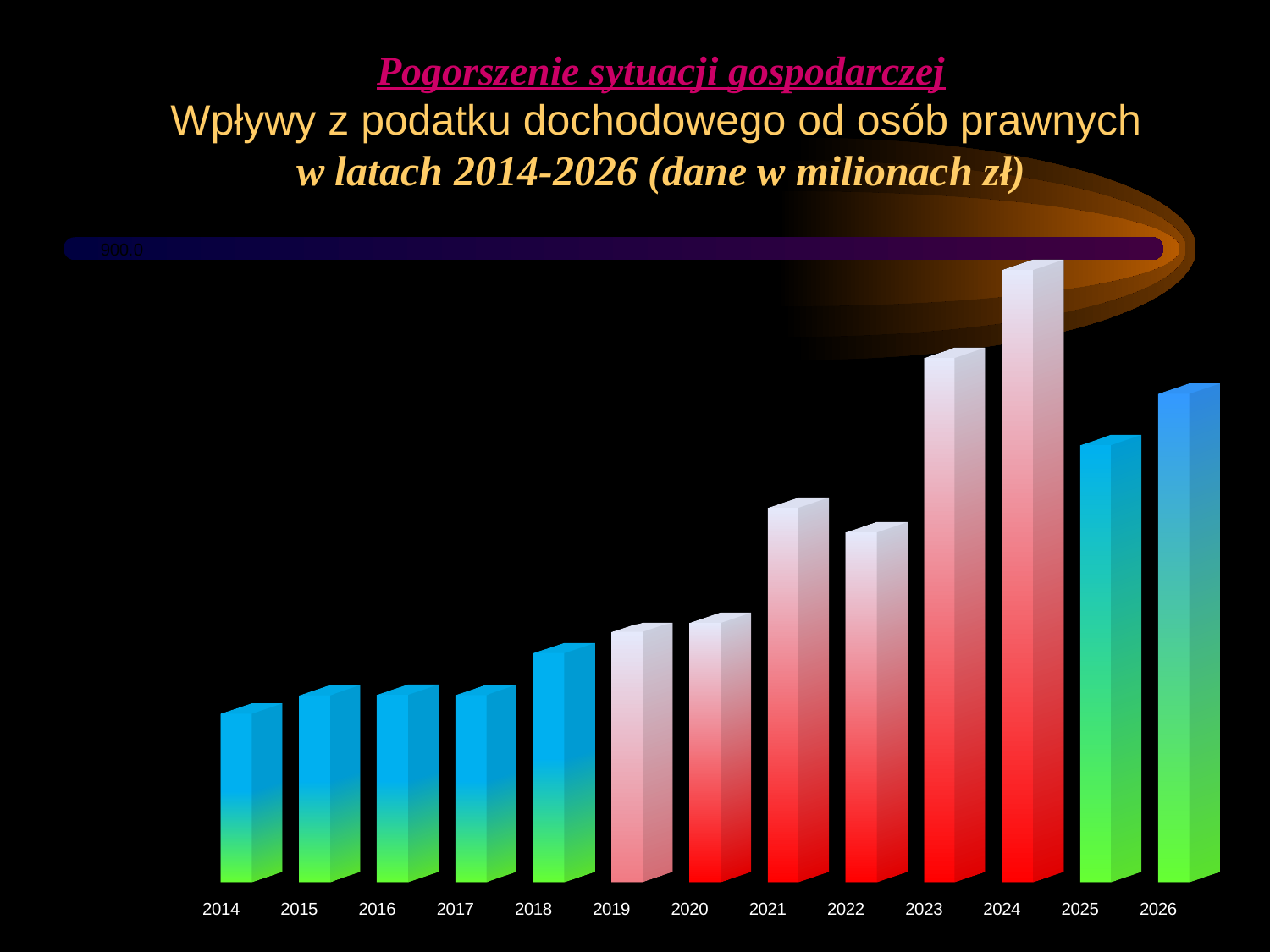
How many years are shown on the x axis of the chart? 13 What kind of chart is shown on the slide? bar chart Which year has the larger value, 2018 or 2014? 2018 Which year has the larger value, 2024 or 2025? 2024 What is the first year shown on the x axis of the chart? 2014 Which year has the larger value, 2025 or 2026? 2026 Which year has the highest bar in the chart? 2024 Do the values generally rise or fall from 2014 to 2024? rise Which year has the lowest bar in the chart? 2014 In what unit are the data in the chart given, according to the title? milionach zł